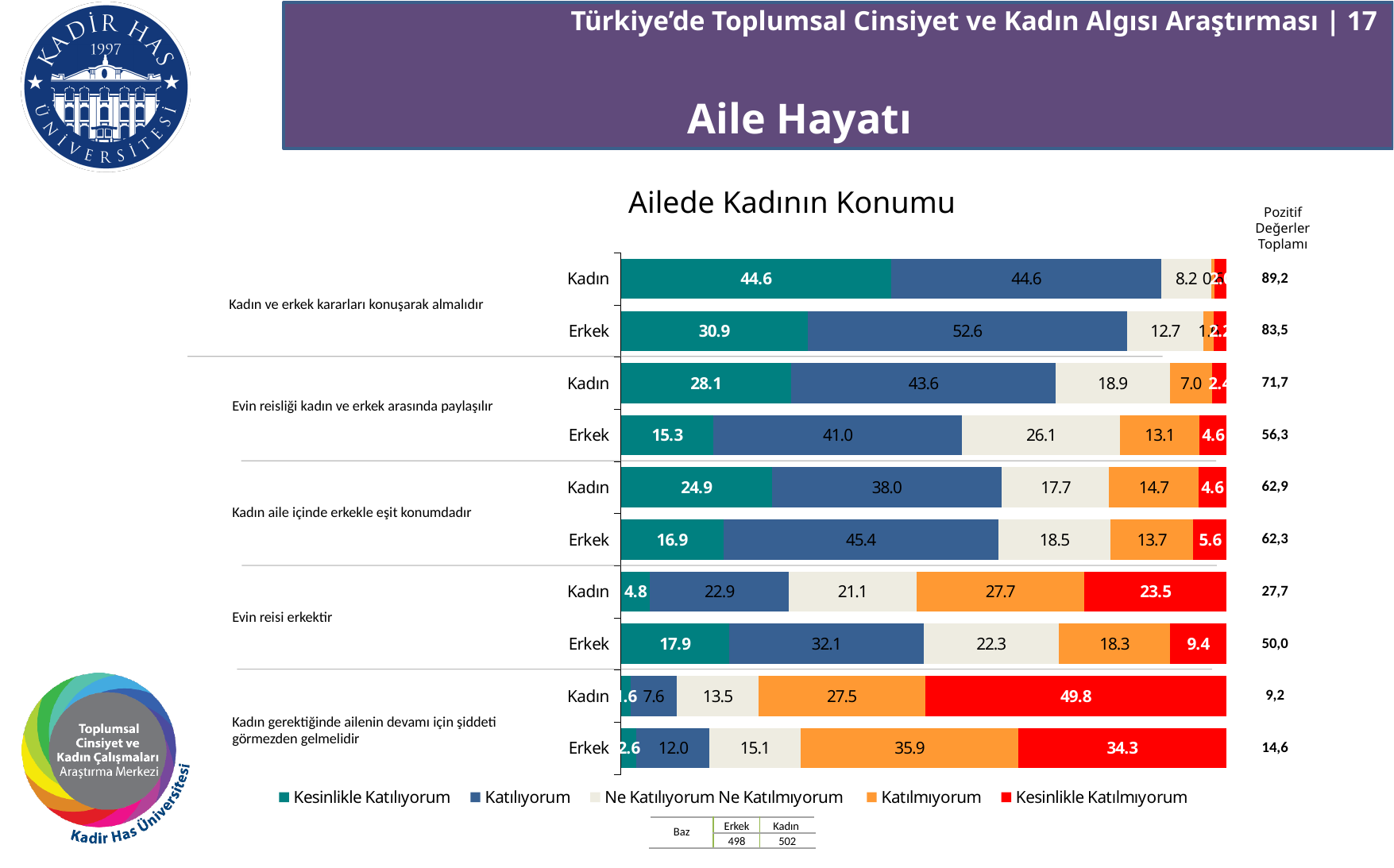
For the statement 'Evin reisi erkektir', which group has the larger 'Kesinlikle Katılıyorum' value, Kadın or Erkek? Erkek What is the 'Pozitif Değerler Toplamı' for Kadın on the statement 'Kadın ve erkek kararları konuşarak almalıdır'? 89,2 Among the Kadın bars, which statement has the highest 'Kesinlikle Katılmıyorum' value? Kadın gerektiğinde ailenin devamı için şiddeti görmezden gelmelidir What kind of chart is shown on the slide? bar chart For the statement 'Evin reisi erkektir', what is the difference between the 'Kesinlikle Katılmıyorum' values for Kadın (23.5) and Erkek (9.4)? 14.1 What is the 'Katılıyorum' value for Erkek on the statement 'Kadın ve erkek kararları konuşarak almalıdır'? 52.6 What is the 'Kesinlikle Katılıyorum' value for Kadın on the statement 'Kadın ve erkek kararları konuşarak almalıdır'? 44.6 What is the 'Ne Katılıyorum Ne Katılmıyorum' value for Erkek on the statement 'Evin reisliği kadın ve erkek arasında paylaşılır'? 26.1 How many statements are shown in the chart? 5 What is the 'Katılmıyorum' value for Erkek on the statement 'Kadın gerektiğinde ailenin devamı için şiddeti görmezden gelmelidir'? 35.9 What is the 'Kesinlikle Katılmıyorum' value for Kadın on the statement 'Kadın gerektiğinde ailenin devamı için şiddeti görmezden gelmelidir'? 49.8 How many series does the legend of the chart list? 5